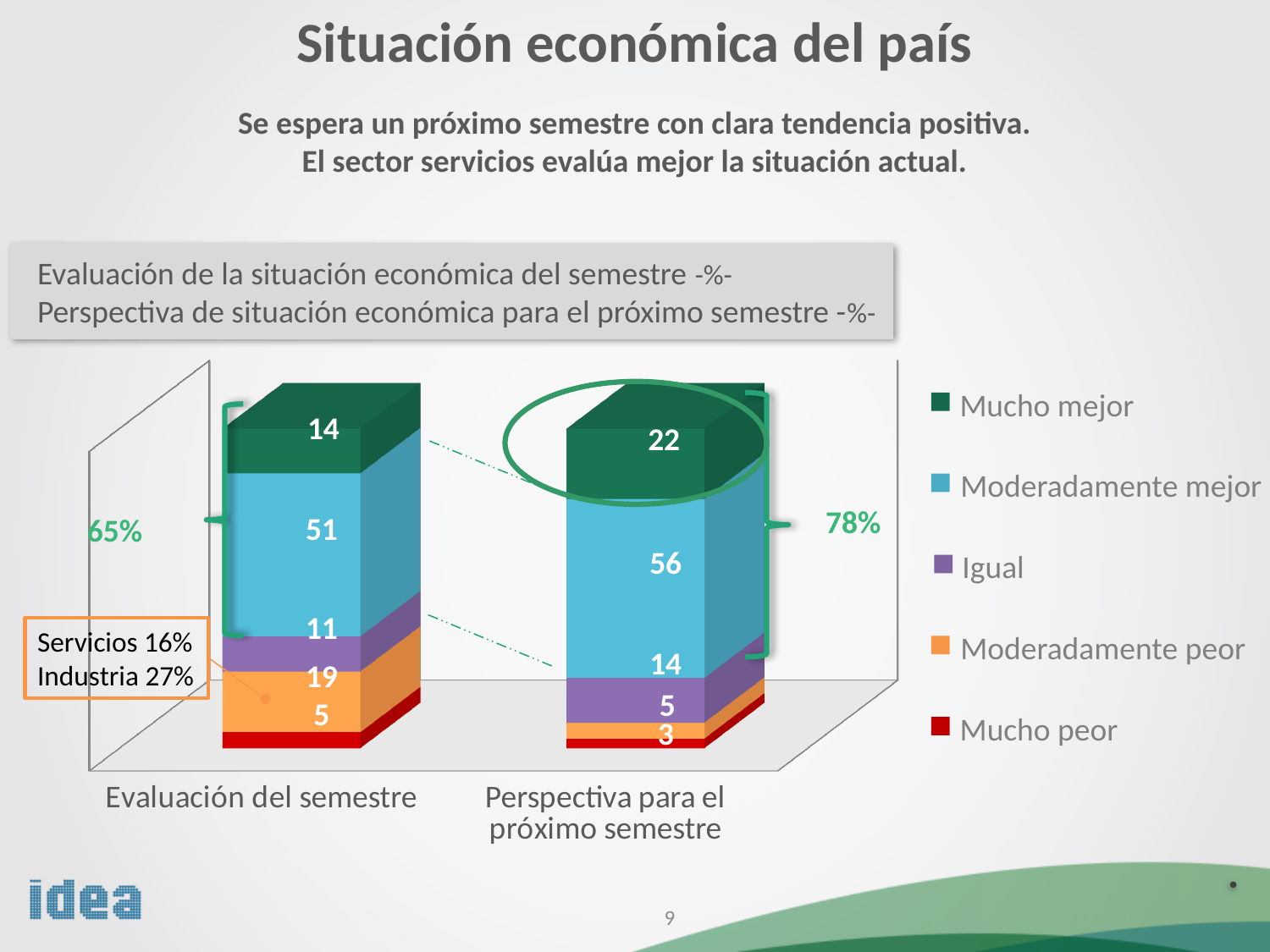
What is the difference between the "Mucho mejor" values of the two bars? 8 Which bar has the larger "Igual" value, "Evaluación del semestre" or "Perspectiva para el próximo semestre"? Perspectiva para el próximo semestre What is the value for "Mucho peor" in the "Perspectiva para el próximo semestre" bar? 3 How many categories (bars) does the chart show? 2 What kind of chart is shown on the slide? Stacked bar chart Which series has the largest segment in the "Evaluación del semestre" bar? Moderadamente mejor What is the value for "Mucho mejor" in the "Evaluación del semestre" bar? 14 What is the value for "Moderadamente peor" in the "Evaluación del semestre" bar? 19 What is the value for "Moderadamente mejor" in the "Perspectiva para el próximo semestre" bar? 56 Which series has the smallest segment in the "Perspectiva para el próximo semestre" bar? Mucho peor How many series does the legend list? 5 What is the total of the "Perspectiva para el próximo semestre" stacked bar? 100